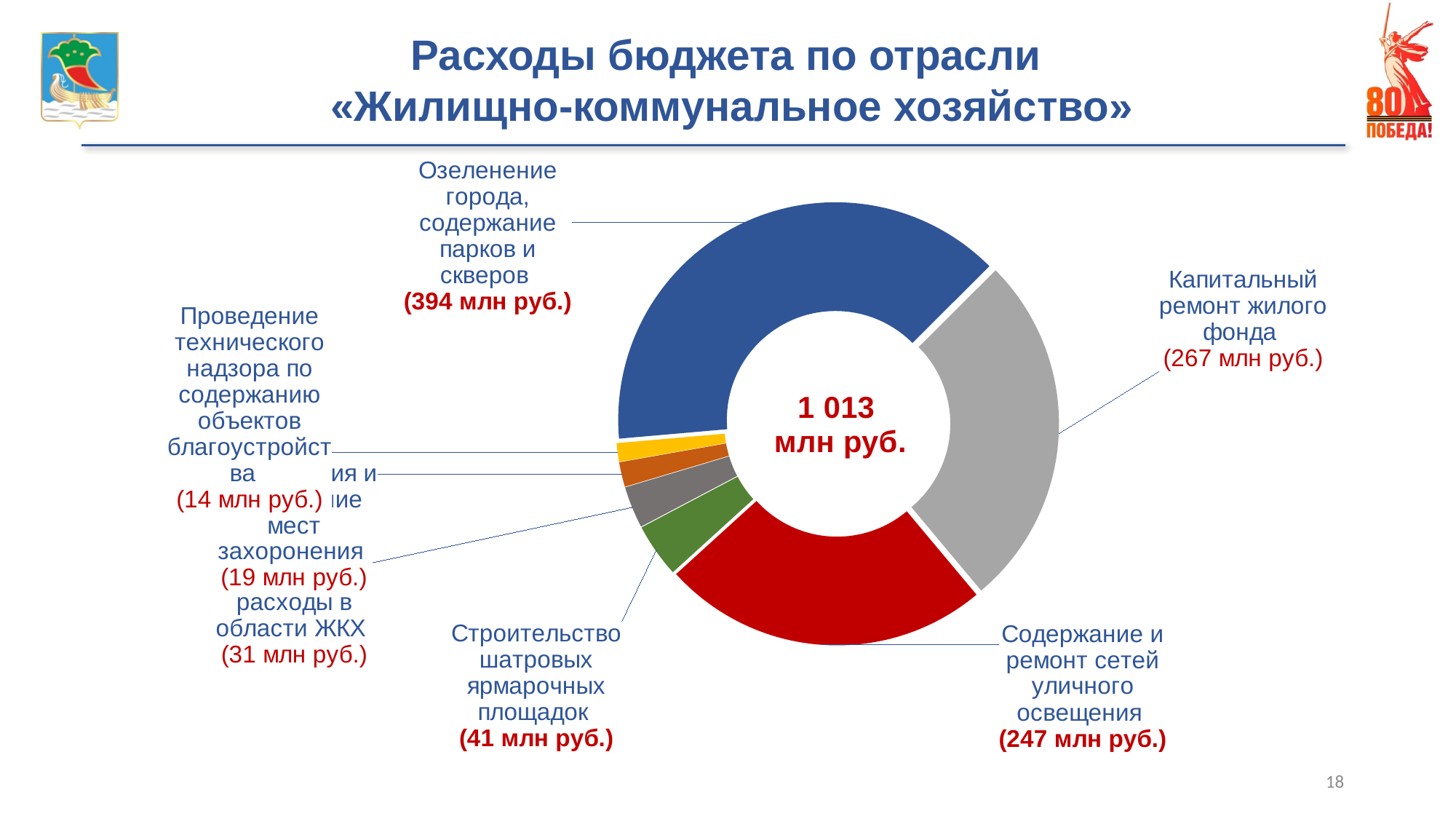
What is the difference between «Капитальный ремонт жилого фонда» and «Содержание и ремонт сетей уличного освещения»? 20 млн руб. How many slices does the chart have? 7 What is the value for «Проведение технического надзора по содержанию объектов благоустройства»? 14 млн руб. What is the value for «Строительство шатровых ярмарочных площадок»? 41 млн руб. What is the difference between «Озеленение города, содержание парков и скверов» and «Капитальный ремонт жилого фонда»? 127 млн руб. What is the value for «Содержание и ремонт сетей уличного освещения»? 247 млн руб. What is the value for «Капитальный ремонт жилого фонда»? 267 млн руб. Which is larger: «Капитальный ремонт жилого фонда» or «Содержание и ремонт сетей уличного освещения»? Капитальный ремонт жилого фонда What total is shown in the centre of the chart? 1 013 млн руб. What kind of chart is shown on the slide? Pie (donut) chart What is the value for «Озеленение города, содержание парков и скверов»? 394 млн руб. Which category has the largest expense? Озеленение города, содержание парков и скверов